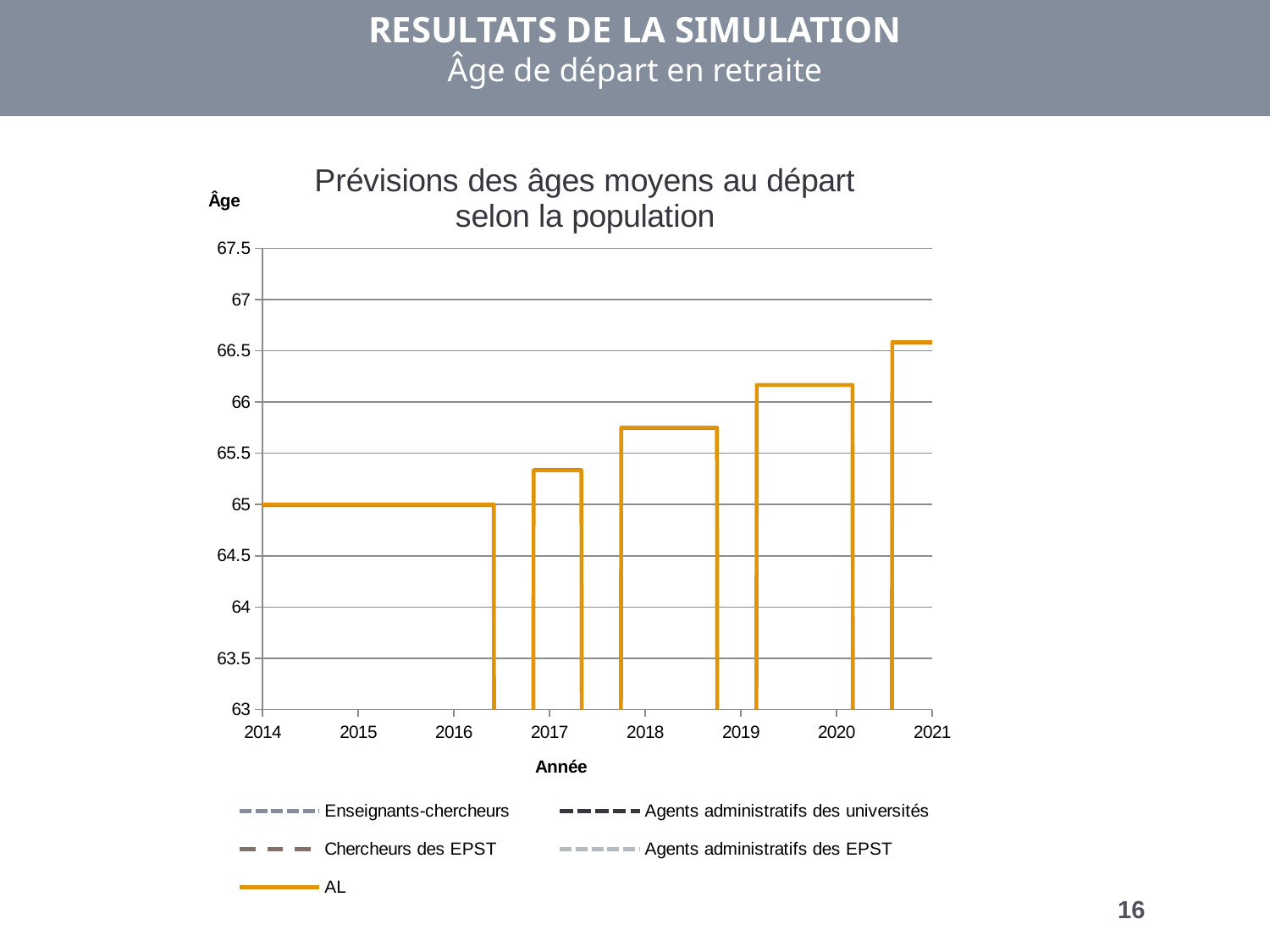
Is the value of the AL series in 2020 greater or less than 67? less Which series is drawn with a solid orange line? AL What kind of chart is shown on the slide? line chart What is the title of the chart? Prévisions des âges moyens au départ selon la population Is the value of the AL series in 2018 greater or less than 65.5? greater What is the value of the AL series in 2014? 65 What is the value of the AL series in 2015? 65 Which is larger for the AL series, the value in 2017 or the value in 2019? 2019 What is the label of the x axis? Année How many series does the chart's legend list? 5 Is the value of the AL series in 2019 greater or less than 66? greater Does the AL series rise or fall from 2016 to 2020? rise